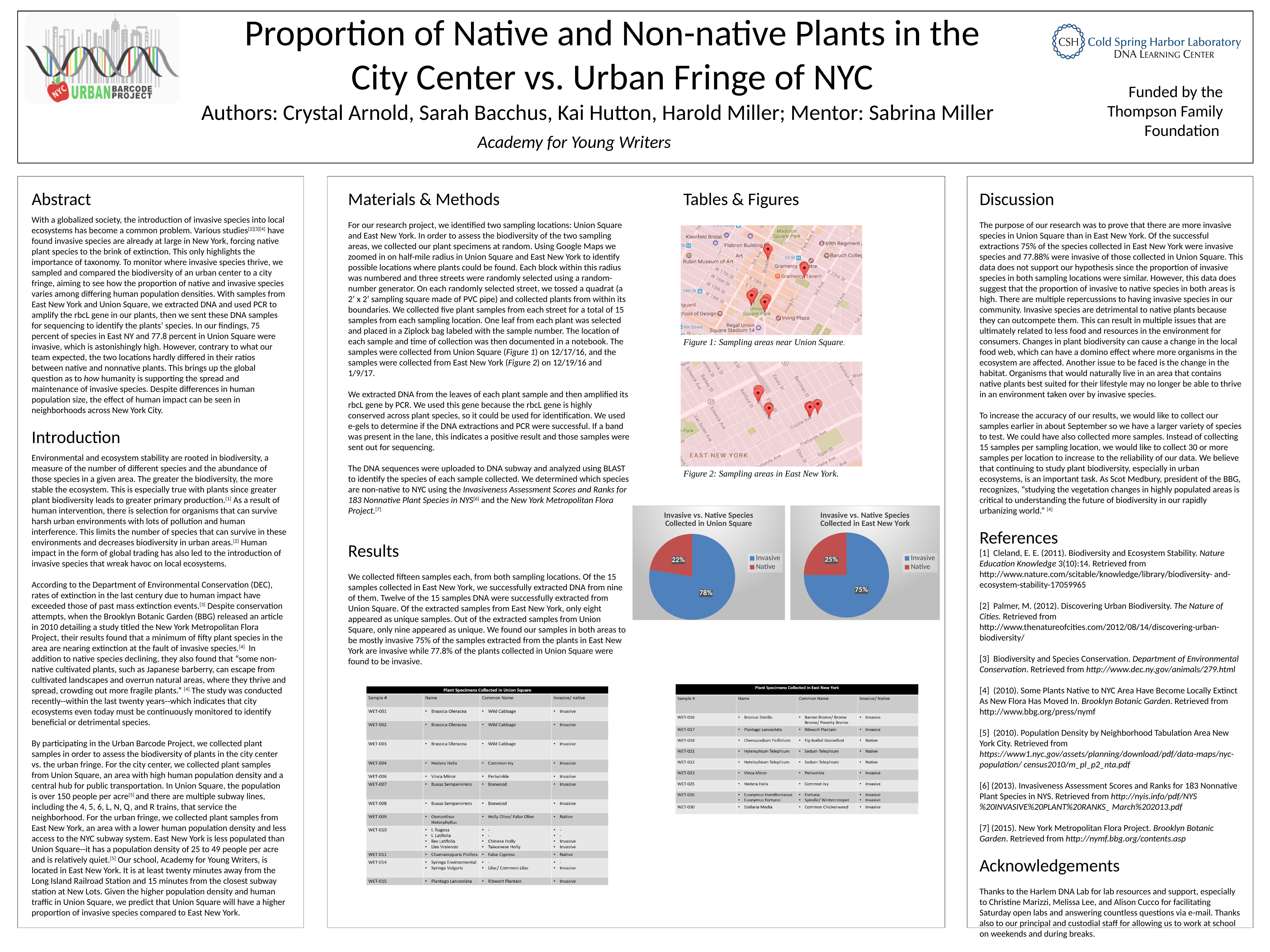
In the 'Invasive vs. Native Species Collected in Union Square' chart, what share of the pie is Invasive? 78% What type of chart is 'Invasive vs. Native Species Collected in Union Square'? Pie chart In the 'Invasive vs. Native Species Collected in Union Square' chart, what colour is the Native slice? Red In the 'Invasive vs. Native Species Collected in East New York' chart, what is the difference in percentage points between the Invasive and Native slices? 50 In the 'Invasive vs. Native Species Collected in East New York' chart, what share of the pie is Native? 25% How many categories does the legend of the 'Invasive vs. Native Species Collected in East New York' chart list? 2 In the 'Invasive vs. Native Species Collected in Union Square' chart, what is the difference in percentage points between the Invasive and Native slices? 56 Which chart shows a larger Native share: the Union Square chart or the East New York chart? East New York In the 'Invasive vs. Native Species Collected in Union Square' chart, which category has the largest slice? Invasive In the 'Invasive vs. Native Species Collected in Union Square' chart, what share of the pie is Native? 22% In the 'Invasive vs. Native Species Collected in East New York' chart, what share of the pie is Invasive? 75% In the 'Invasive vs. Native Species Collected in East New York' chart, which category has the smallest slice? Native